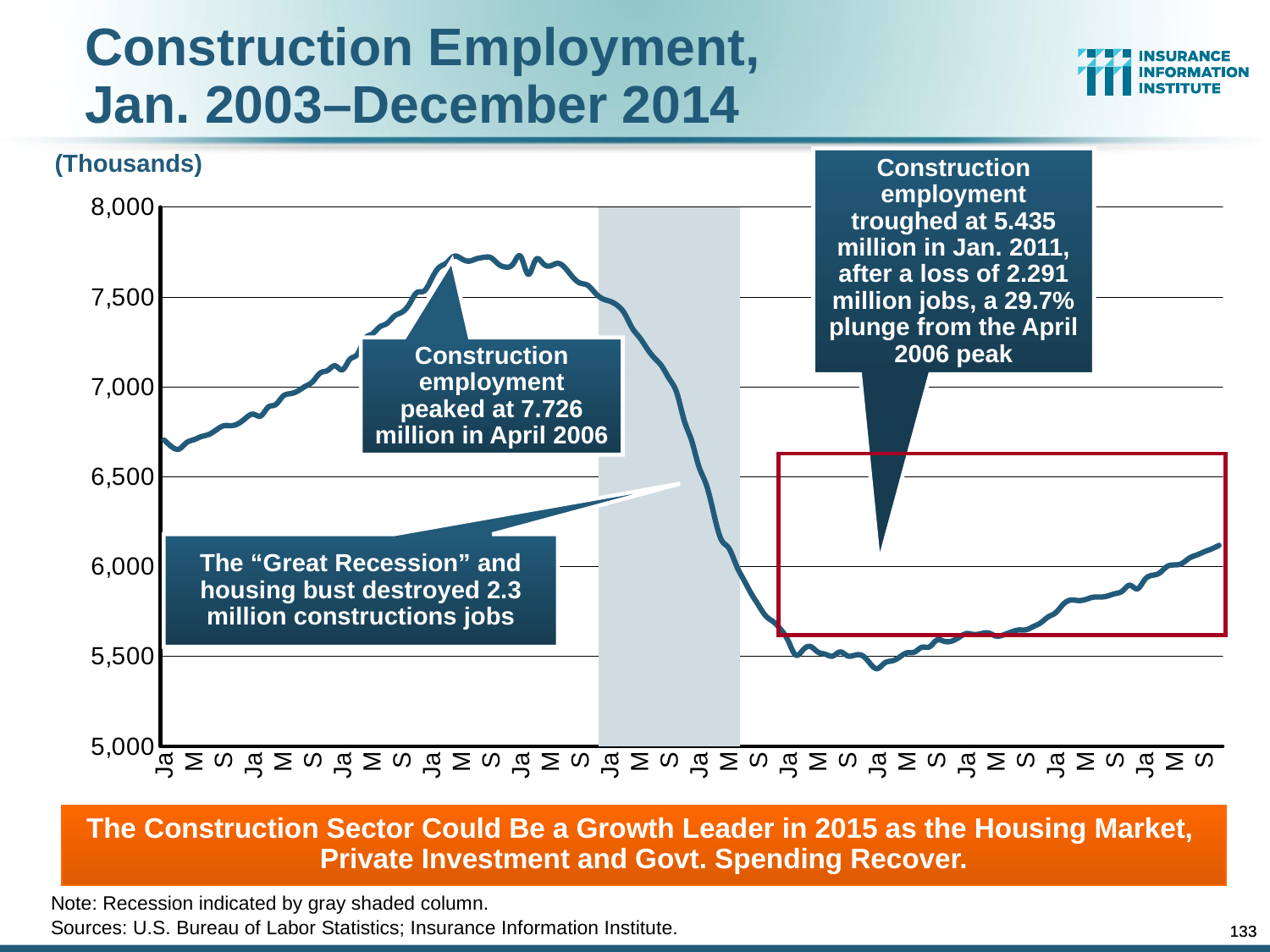
In which month and year did construction employment peak? April 2006 What percentage plunge from the April 2006 peak does the callout report for the Jan. 2011 trough? 29.7% According to the callout, at what level did construction employment peak? 7.726 million What does the gray shaded column on the chart indicate? Recession Does construction employment rise or fall between the April 2006 peak and the Jan. 2011 trough? fall Is the construction employment value at the end of the series (late 2014) greater or less than 6,500? less In which month and year did construction employment reach its trough? Jan. 2011 What kind of chart is shown on the slide? line chart According to the callout, at what level did construction employment trough? 5.435 million In what units are the values on the y axis expressed? Thousands How many jobs were lost between the April 2006 peak and the Jan. 2011 trough, according to the callout? 2.291 million Is the construction employment value at the start of the series (Jan. 2003) greater or less than 6,500? greater